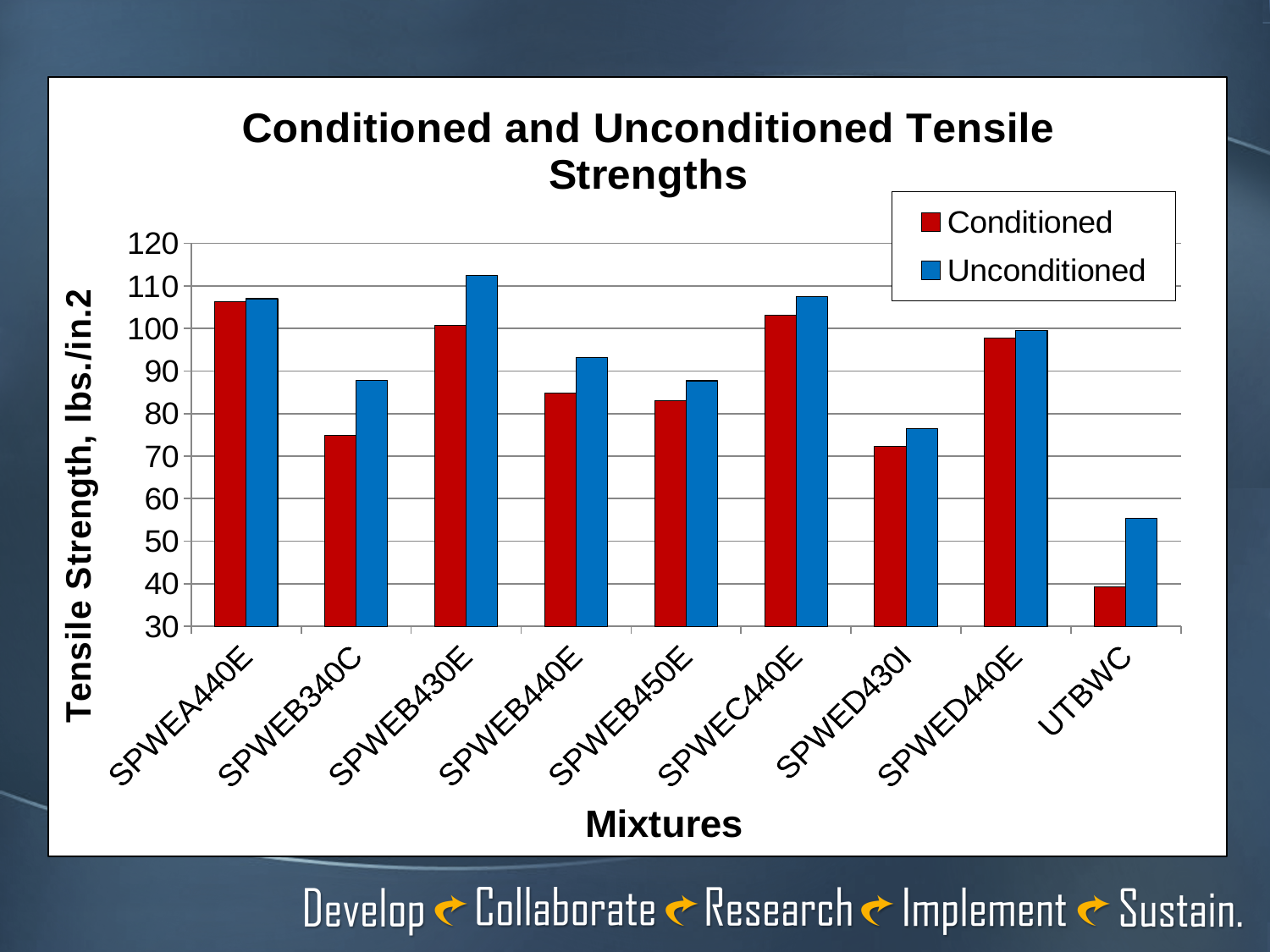
How many series does the legend list? 2 Which mixture has the highest Unconditioned tensile strength? SPWEB430E Which mixture has the lowest Conditioned tensile strength? UTBWC What kind of chart is shown on the slide? bar chart What is the label of the y axis? Tensile Strength, lbs./in.2 Is the Conditioned value for SPWEC440E greater or less than 100? greater Is the Conditioned value for SPWEB340C greater or less than 80? less Is the Unconditioned value for UTBWC greater or less than 50? greater For SPWEB340C, which is larger: the Conditioned or the Unconditioned tensile strength? Unconditioned How many mixtures are shown on the x axis? 9 Which mixture has the lowest Unconditioned tensile strength? UTBWC